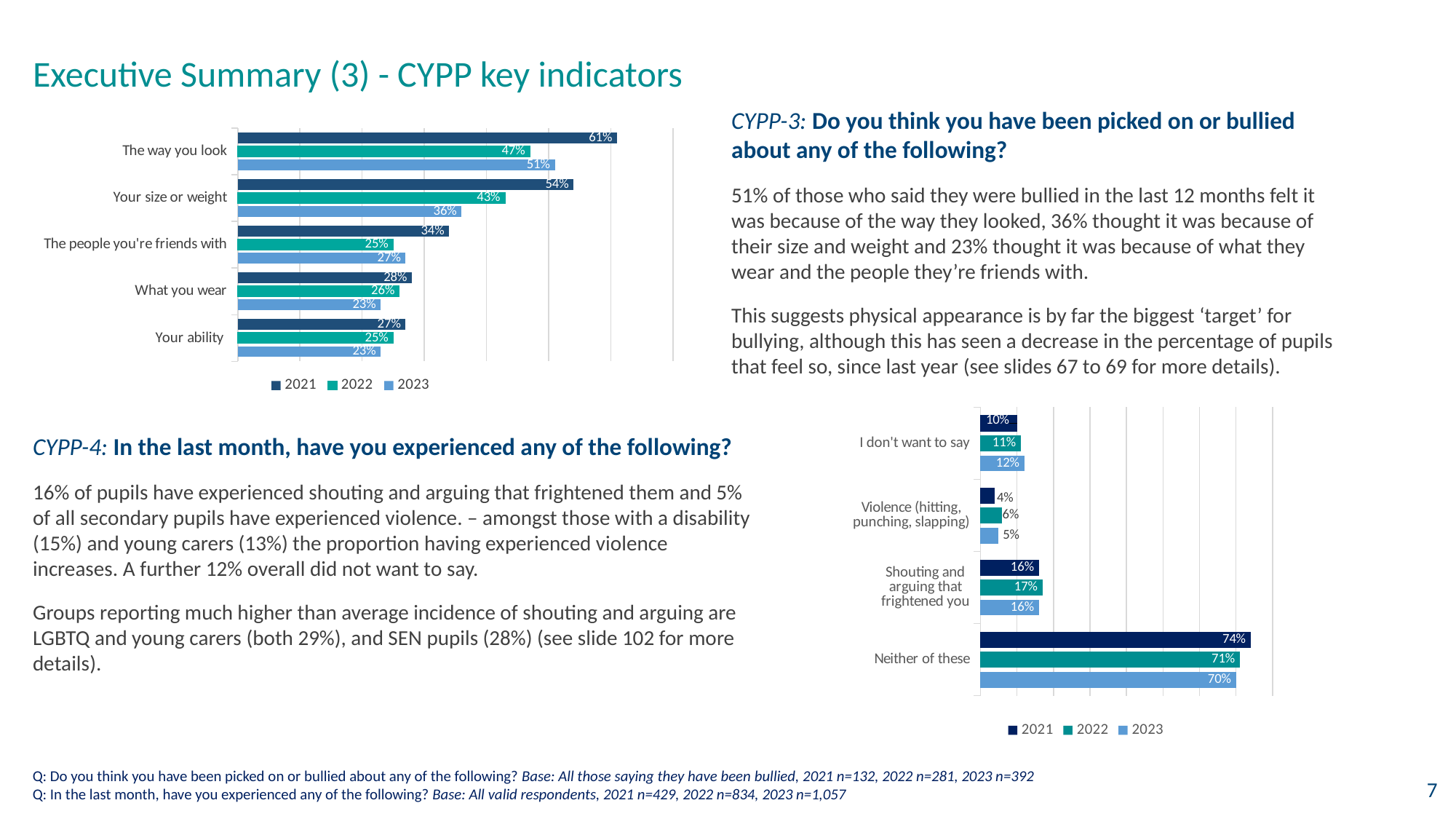
What type of chart is the bottom-right chart? Bar chart In the top-left chart, what is the 2021 value for 'Your size or weight'? 54% In the bottom-right chart, what is the difference between the 2021 and 2023 values for 'Neither of these'? 4 percentage points In the bottom-right chart, what is the 2022 value for 'Violence (hitting, punching, slapping)'? 6% In the top-left chart, what is the difference between the 2021 and 2023 values for 'Your size or weight'? 18 percentage points In the bottom-right chart, which category has the lowest 2021 value? Violence (hitting, punching, slapping) In the top-left chart, how many series does the legend list? 3 In the top-left chart, what is the 2023 value for 'The way you look'? 51% In the bottom-right chart, what is the 2023 value for 'Neither of these'? 70% In the top-left chart, which is larger for 'The way you look': the 2022 value or the 2023 value? 2023 In the top-left chart, which category has the highest 2021 value? The way you look In the top-left chart, how many categories are shown? 5